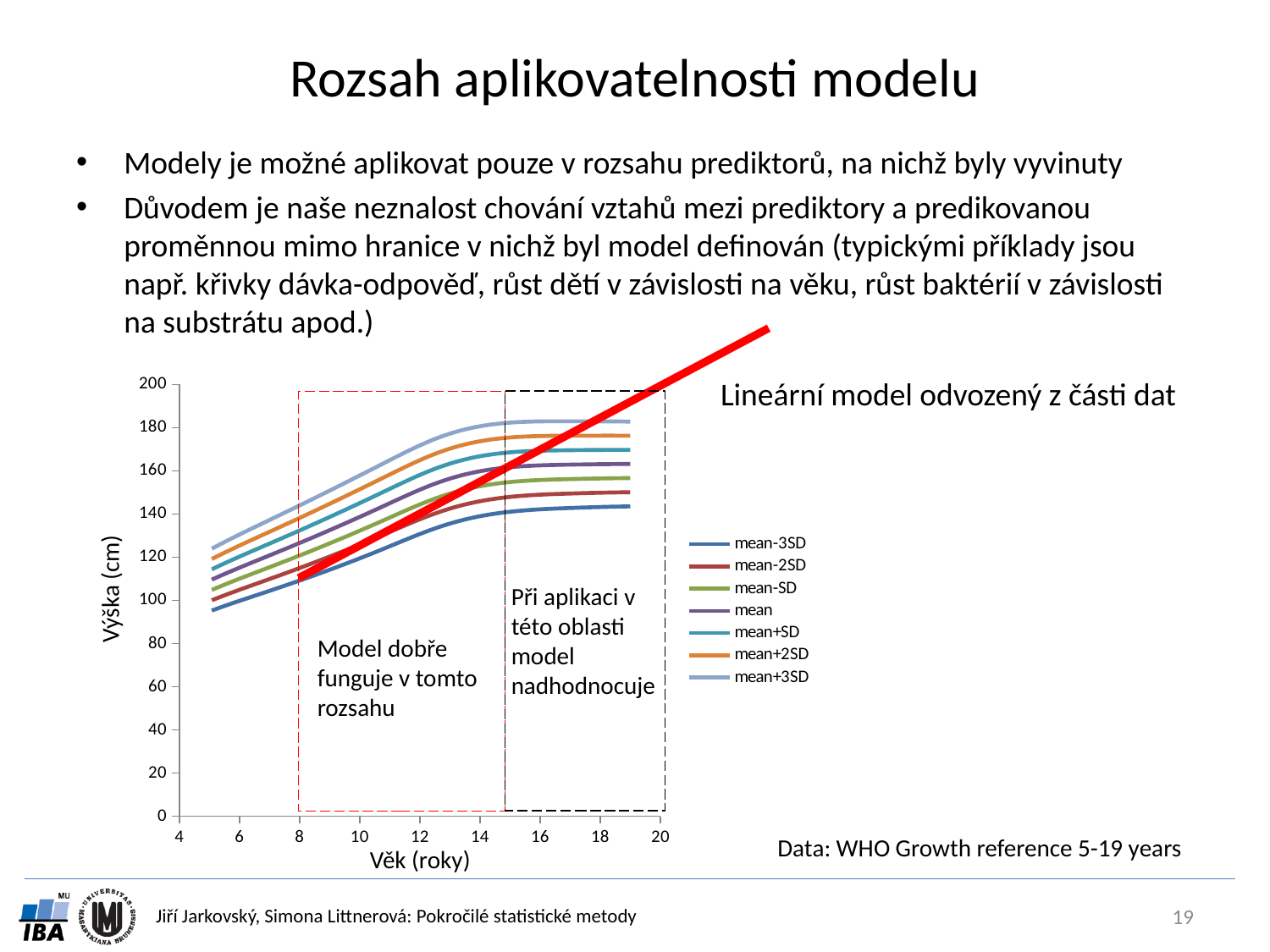
Is the value of the mean+3SD series at age 19 greater or less than 160? greater What is the title of the vertical axis of the chart? Výška (cm) What is the title of the horizontal axis of the chart? Věk (roky) Is the value of the mean-3SD series at age 19 greater or less than 160? less Which series lies highest on the chart? mean+3SD Which series has the highest values across the chart, mean+3SD or mean-3SD? mean+3SD Is the value of the mean-3SD series at age 5 greater or less than 100? less Which series lies lowest on the chart? mean-3SD How many series does the chart legend list? 7 Do the values of the mean series rise or fall as age increases along the x axis? rise What kind of chart is shown on the slide? line chart